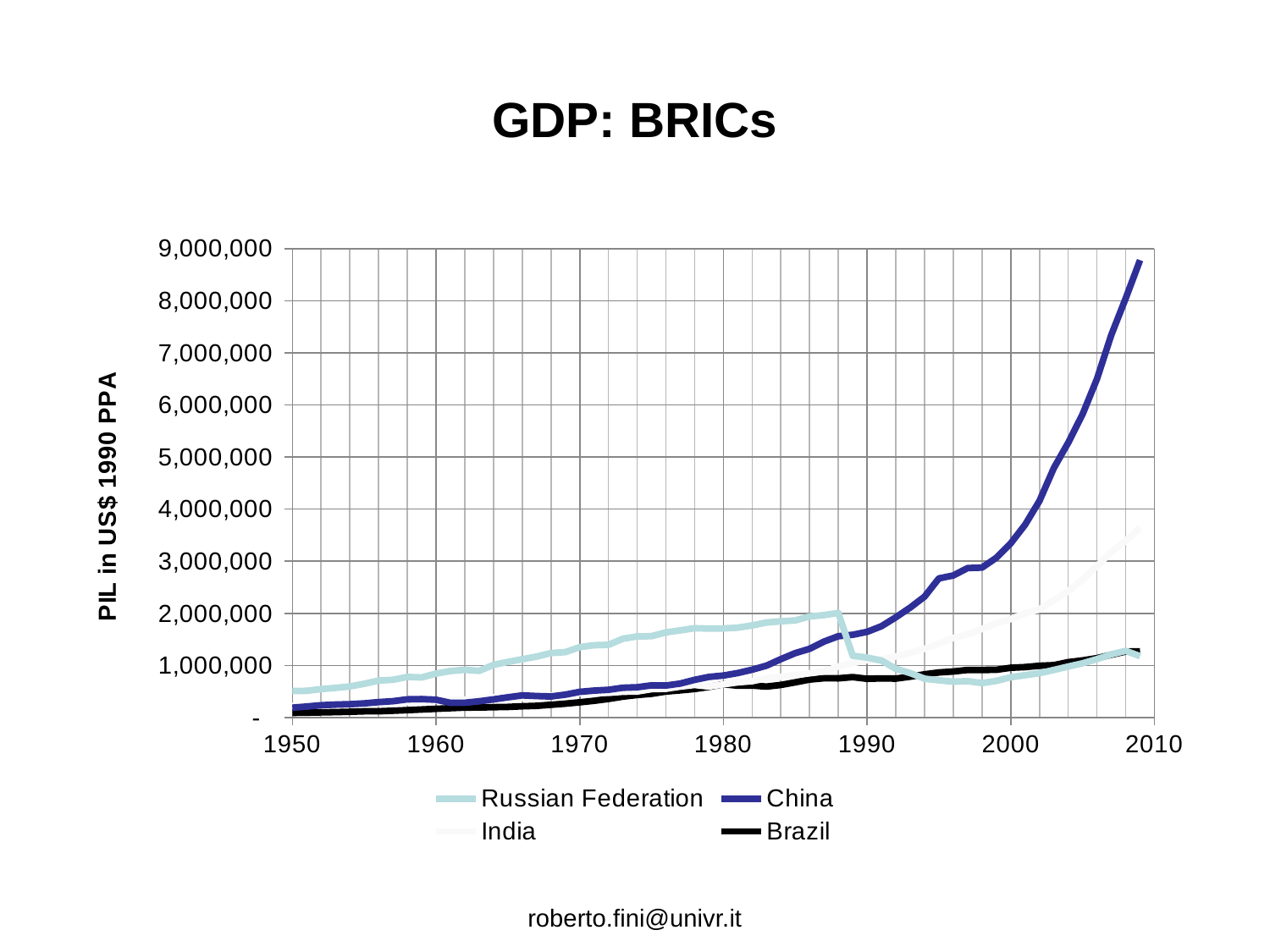
In 1980, which is larger: the value for the Russian Federation or the value for China? Russian Federation Does the value for China rise or fall from 1990 to 2009? rise What kind of chart is shown on the slide? line chart What is the title of the chart? GDP: BRICs Which series has the highest value in 2009? China Is the value for China in 2009 greater or less than 8,000,000? greater Is the value for India in 2009 greater or less than 3,000,000? greater How many series does the legend list? 4 Is the value for Brazil in 2009 greater or less than 1,000,000? greater Which series has the lowest value in 1950? Brazil What is the label on the vertical axis? PIL in US$ 1990 PPA